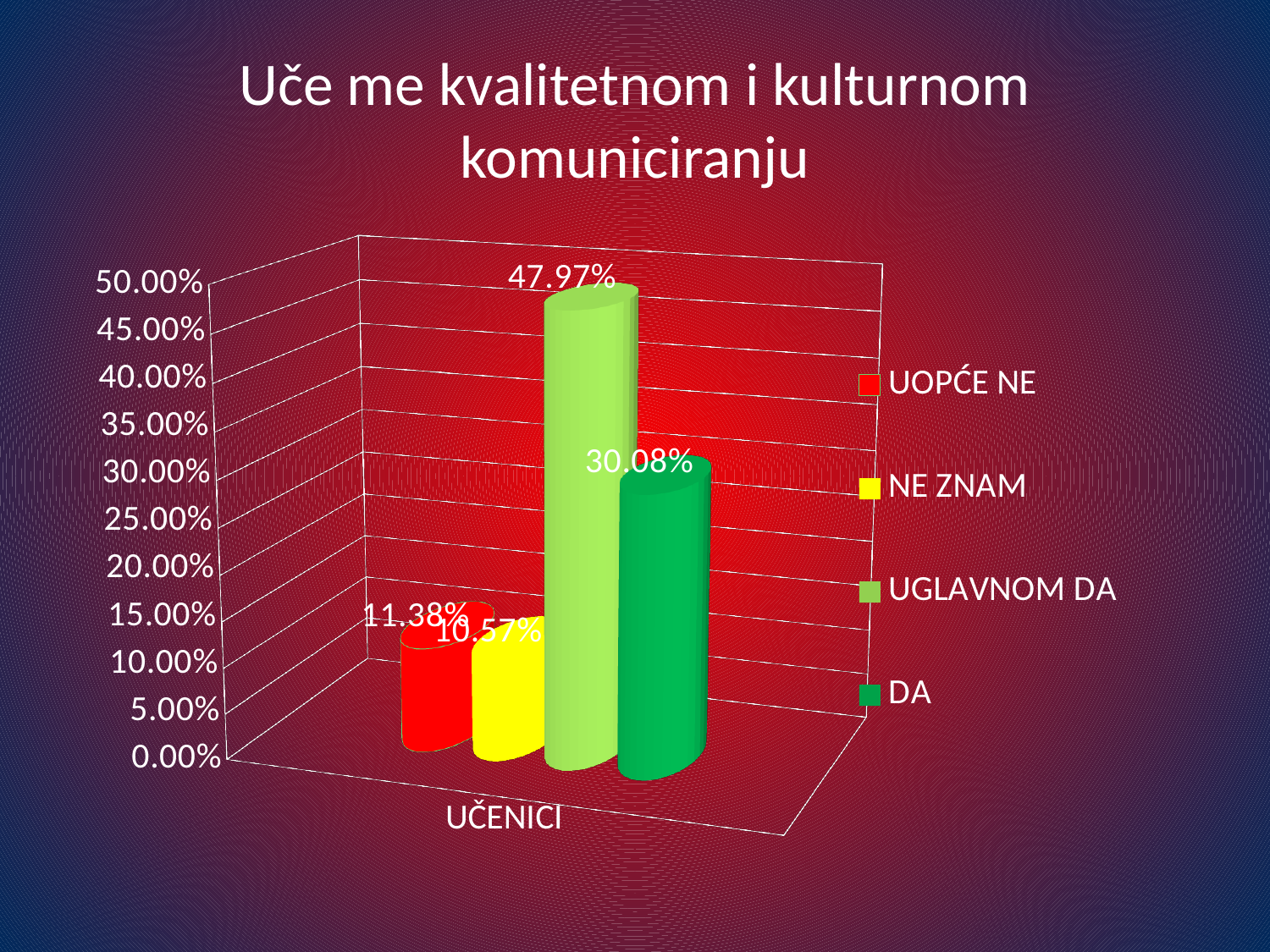
Which is larger, the value for DA or the value for UOPĆE NE? DA What kind of chart is shown on the slide? bar chart What is the value for UGLAVNOM DA? 47.97% What is the value for NE ZNAM? 10.57% What is the value for UOPĆE NE? 11.38% Is the value for DA greater or less than 25.00%? greater How many series does the legend list? 4 What is the difference between the values for UGLAVNOM DA and DA? 17.89% What is the value for DA? 30.08% What is the title of the chart? Uče me kvalitetnom i kulturnom komuniciranju What is the category label on the x axis? UČENICI Which series has the highest value? UGLAVNOM DA